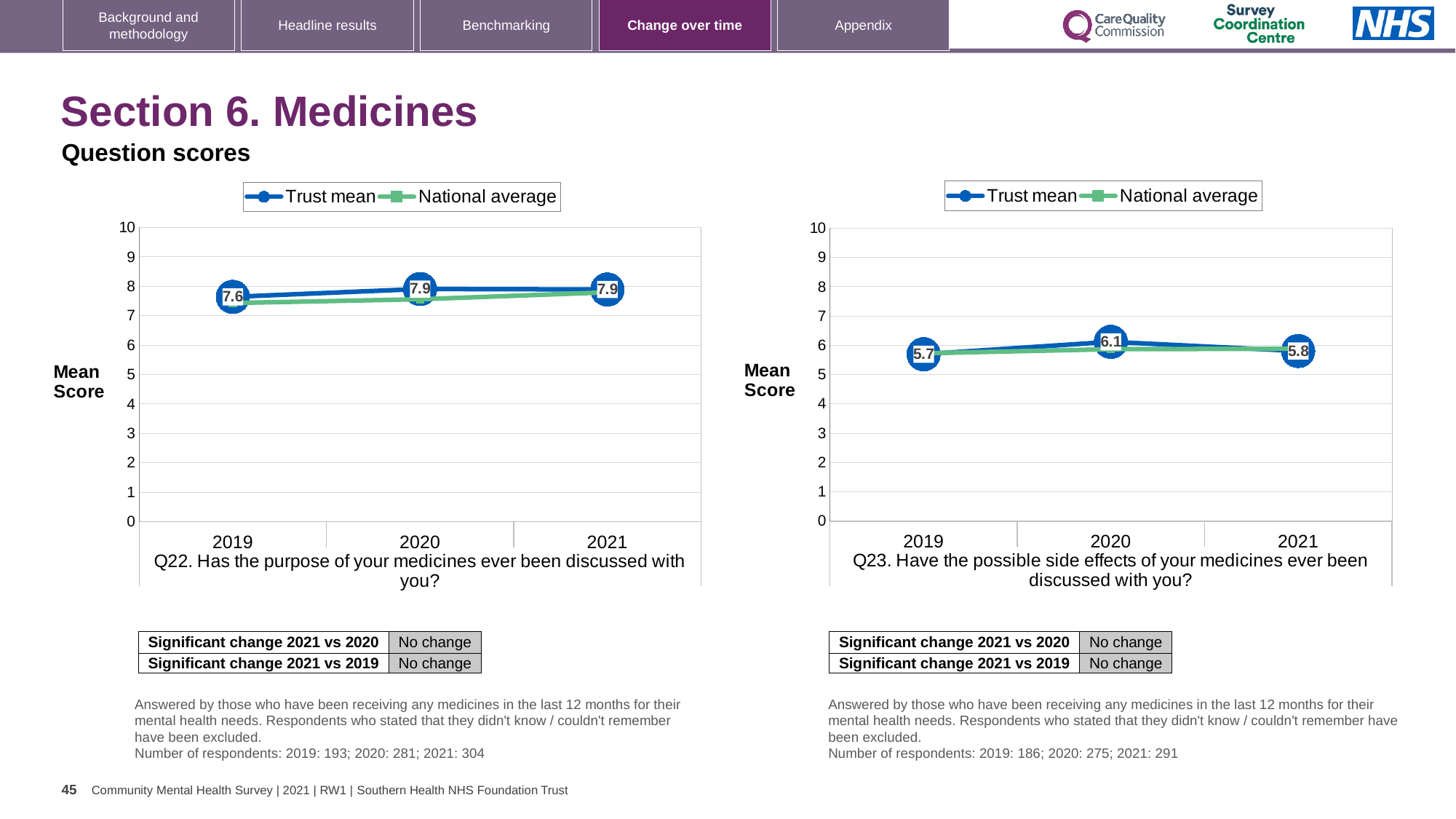
In the right chart (Q23), what is the difference between the Trust mean scores for 2020 and 2019? 0.4 In the left chart (Q22), which year has the lowest Trust mean score? 2019 How many series does the legend of the left chart (Q22) list? 2 In the right chart (Q23), is the Trust mean score for 2021 larger or smaller than the score for 2019? larger In the right chart (Q23), what is the Trust mean score for 2020? 6.1 In the right chart (Q23), which year has the highest Trust mean score? 2020 In the left chart (Q22), what is the Trust mean score for 2019? 7.6 In the left chart (Q22), what is the difference between the Trust mean scores for 2020 and 2019? 0.3 In the left chart (Q22), is the National average value for 2019 greater or less than 8? less In the right chart (Q23), what is the Trust mean score for 2021? 5.8 What kind of chart is the right chart (Q23)? Line chart In the left chart (Q22), what is the Trust mean score for 2021? 7.9